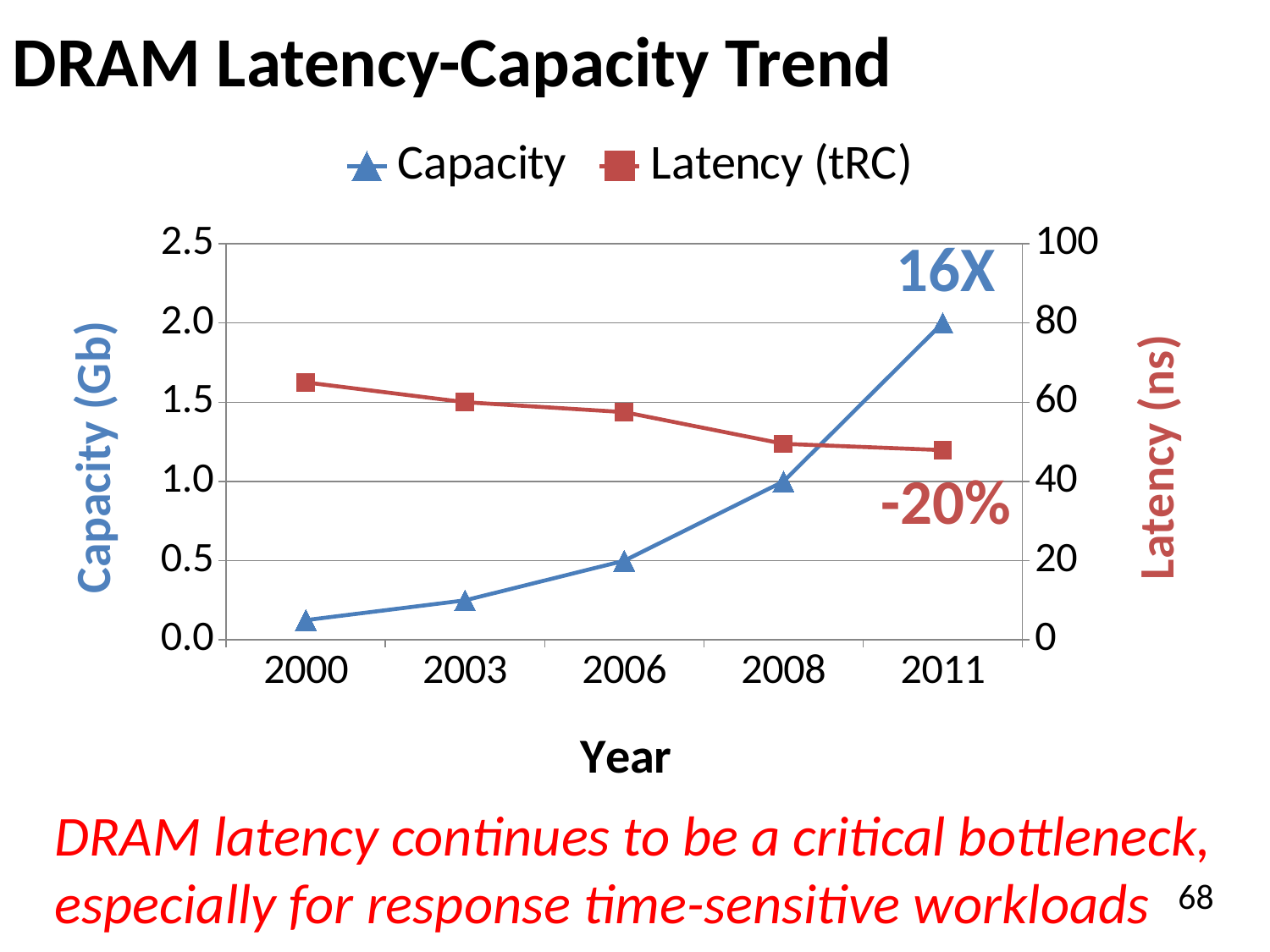
What kind of chart is shown on the slide? line chart Is the Latency (tRC) value for 2000 greater or less than 60? greater What is the difference between the Capacity values for 2011 and 2008? 1.0 What annotation is printed next to the Capacity series near 2011? 16X What is the Capacity value for 2008? 1.0 In which year is Capacity highest? 2011 Does the Latency (tRC) series rise or fall from 2000 to 2011? fall In which year is Latency (tRC) highest? 2000 How many years are plotted along the x axis? 5 How many series does the legend list? 2 Does the Capacity series rise or fall from 2000 to 2011? rise What is the Capacity value for 2011? 2.0